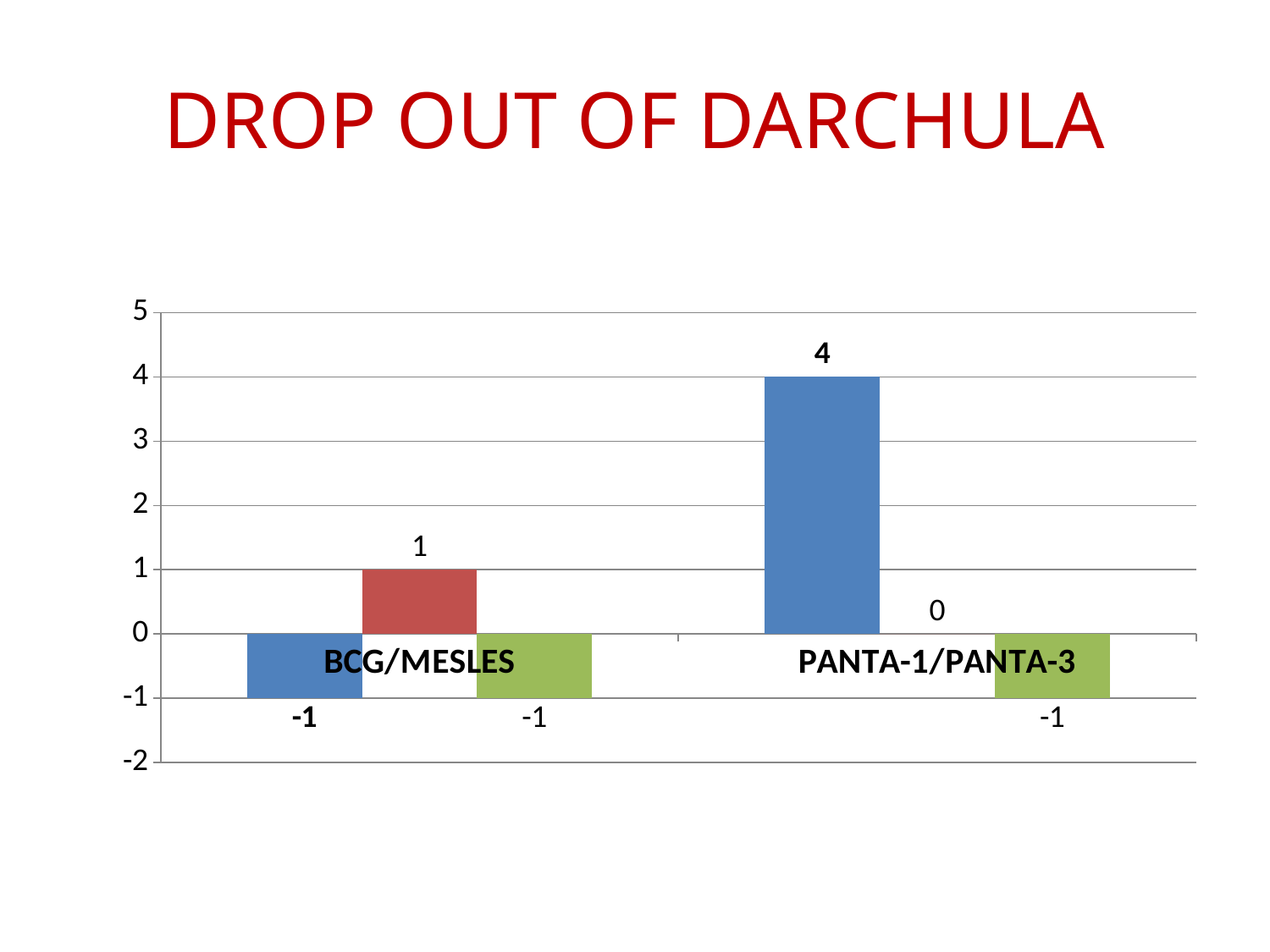
What is the value of the green bar for PANTA-1/PANTA-3? -1 How many bars are plotted for each category? 3 What is the difference between the blue bar for PANTA-1/PANTA-3 and the blue bar for BCG/MESLES? 5 What is the title of the slide? DROP OUT OF DARCHULA What is the value of the red bar for PANTA-1/PANTA-3? 0 What type of chart is shown on the slide? bar chart How many categories are shown on the x axis? 2 What is the value of the blue bar for BCG/MESLES? -1 Which is larger, the red bar for BCG/MESLES or the red bar for PANTA-1/PANTA-3? the red bar for BCG/MESLES Which bar has the highest value in the chart? the blue bar for PANTA-1/PANTA-3 What is the value of the red bar for BCG/MESLES? 1 What is the value of the blue bar for PANTA-1/PANTA-3? 4